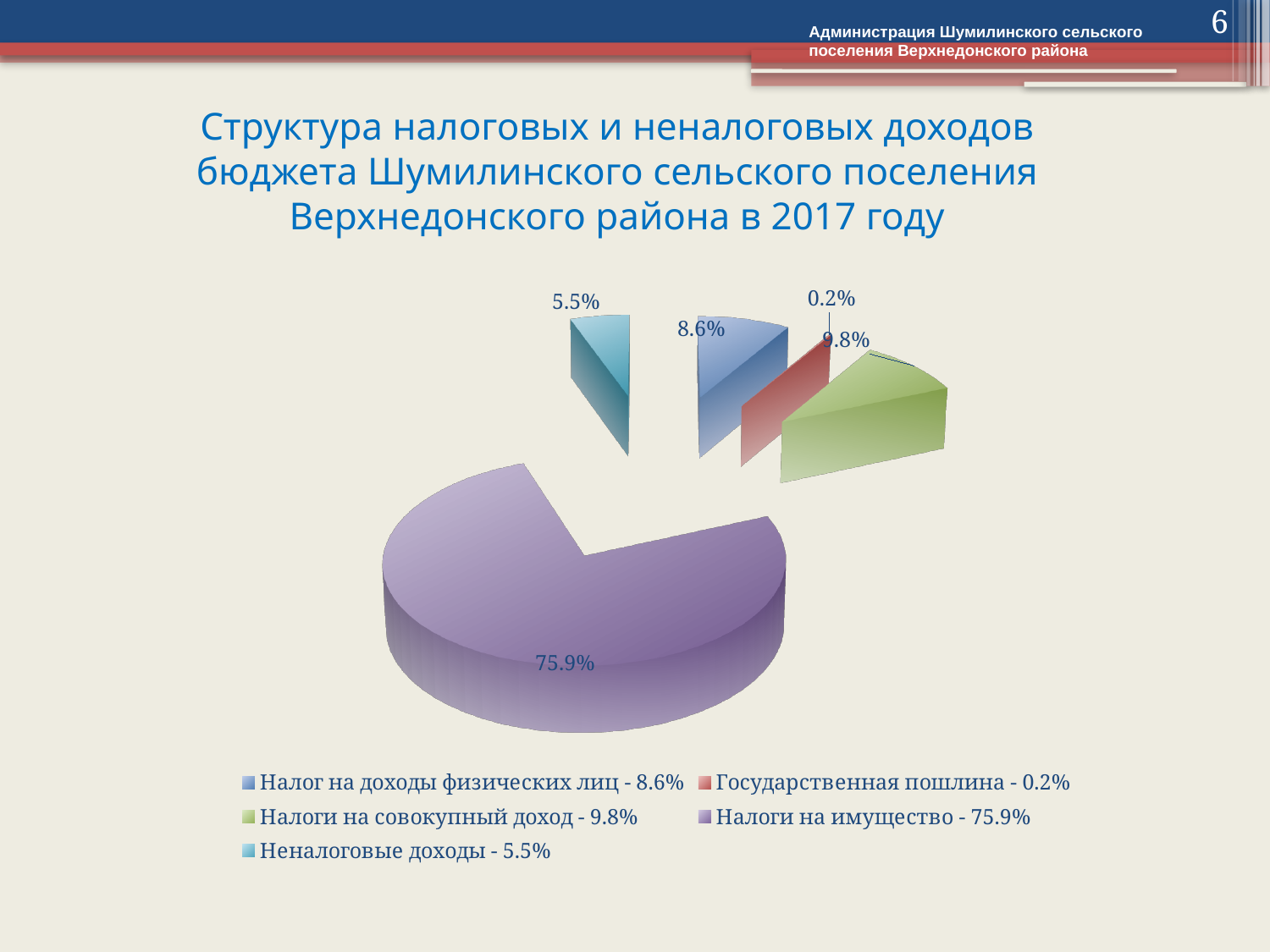
How many slices does the pie chart have? 5 How many entries does the legend list? 5 What share of the pie is Налоги на имущество? 75.9% What share of the pie is Налоги на совокупный доход? 9.8% What share of the pie is Налог на доходы физических лиц? 8.6% Which category has the smallest share of the pie? Государственная пошлина What is the difference between the share for Налоги на имущество and the share for Налоги на совокупный доход? 66.1% What kind of chart is shown on the slide? Pie chart Which category has the largest share of the pie? Налоги на имущество Which is larger: the share for Налоги на совокупный доход or the share for Налог на доходы физических лиц? Налоги на совокупный доход